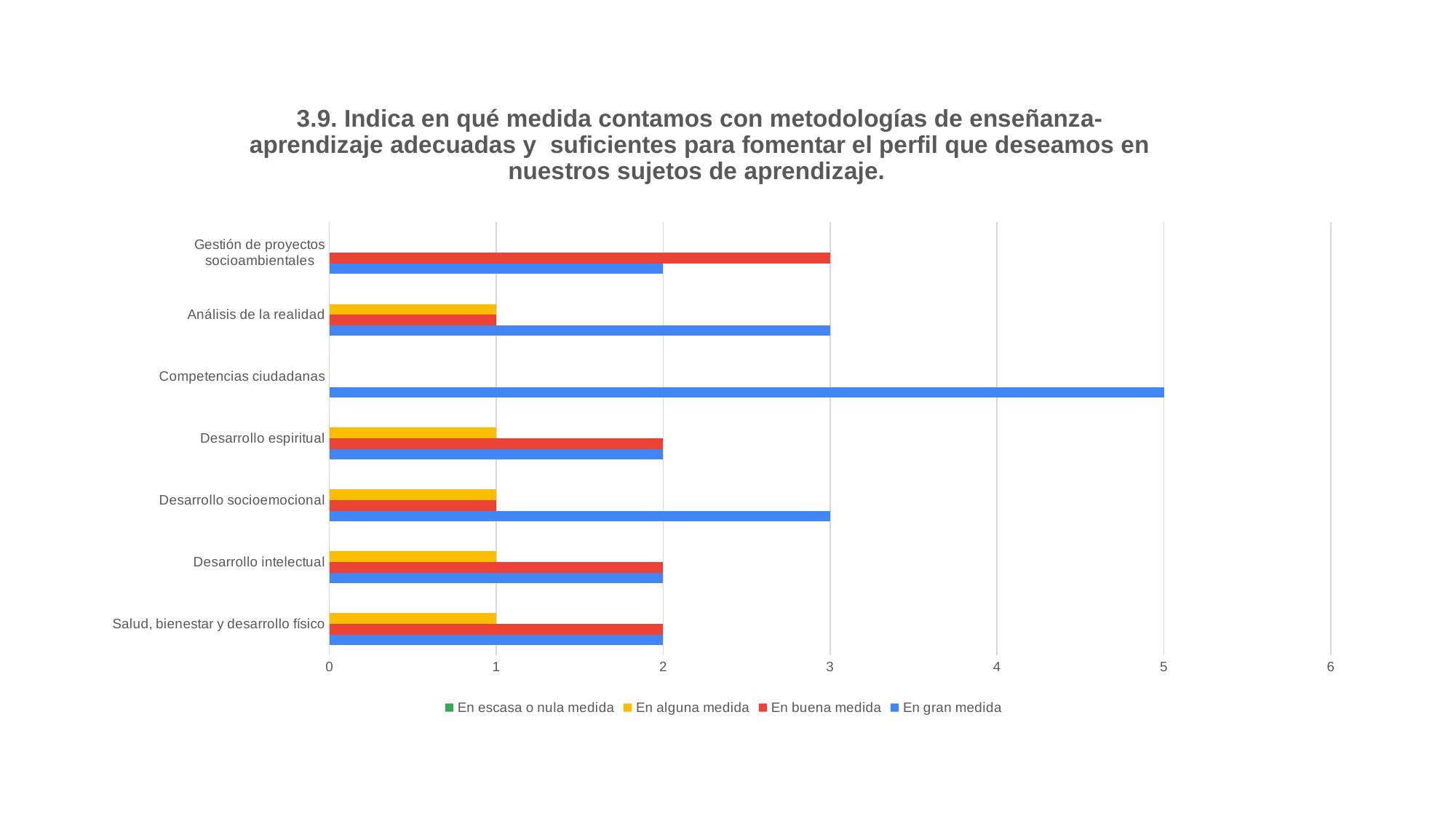
Which legend entry is shown in blue? En gran medida What is the value of 'En gran medida' for Competencias ciudadanas? 5 What is the value of 'En gran medida' for Análisis de la realidad? 3 What is the value of 'En buena medida' for Gestión de proyectos socioambientales? 3 Which category has the highest 'En buena medida' value? Gestión de proyectos socioambientales How many categories are shown on the vertical axis? 7 Which is larger for Gestión de proyectos socioambientales: 'En buena medida' or 'En gran medida'? En buena medida Which category has the highest 'En gran medida' value? Competencias ciudadanas Is the 'En gran medida' value for Competencias ciudadanas greater or less than 4? greater What is the difference between the 'En gran medida' values for Competencias ciudadanas and Desarrollo espiritual? 3 How many series does the legend list? 4 What kind of chart is shown on the slide? bar chart